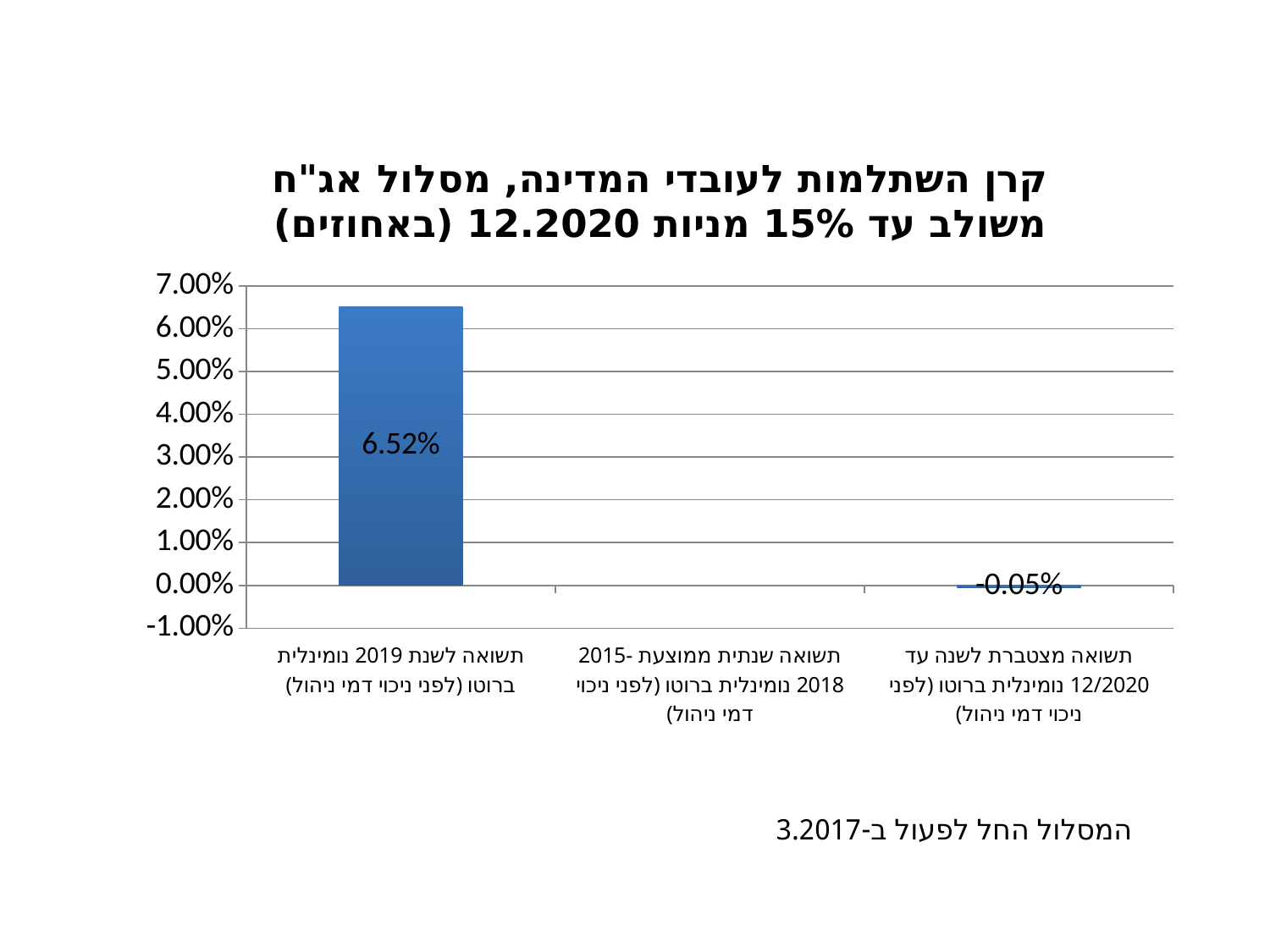
Which category has the highest value? תשואה לשנת 2019 נומינלית ברוטו (לפני ניכוי דמי ניהול) What is the difference between the 2019 return (6.52%) and the cumulative return to 12/2020 (-0.05%)? 6.57% Which of the two labelled categories has the lowest value? תשואה מצטברת לשנה עד 12/2020 נומינלית ברוטו (לפני ניכוי דמי ניהול) What is the value for the cumulative return for the year to 12/2020 (תשואה מצטברת לשנה עד 12/2020)? -0.05% Which is larger: the 2019 nominal gross return or the cumulative return to 12/2020? The 2019 nominal gross return What kind of chart is shown on the slide? Bar chart How many categories are shown on the x axis? 3 Is the value for the 2019 nominal gross return greater or less than 6.00%? greater Is the value for the cumulative return to 12/2020 greater or less than 1.00%? less Which category on the chart has no bar plotted? תשואה שנתית ממוצעת 2015-2018 נומינלית ברוטו (לפני ניכוי דמי ניהול) What is the value for the 2019 nominal gross return (תשואה לשנת 2019 נומינלית ברוטו)? 6.52% What is the highest value shown on the y axis? 7.00%